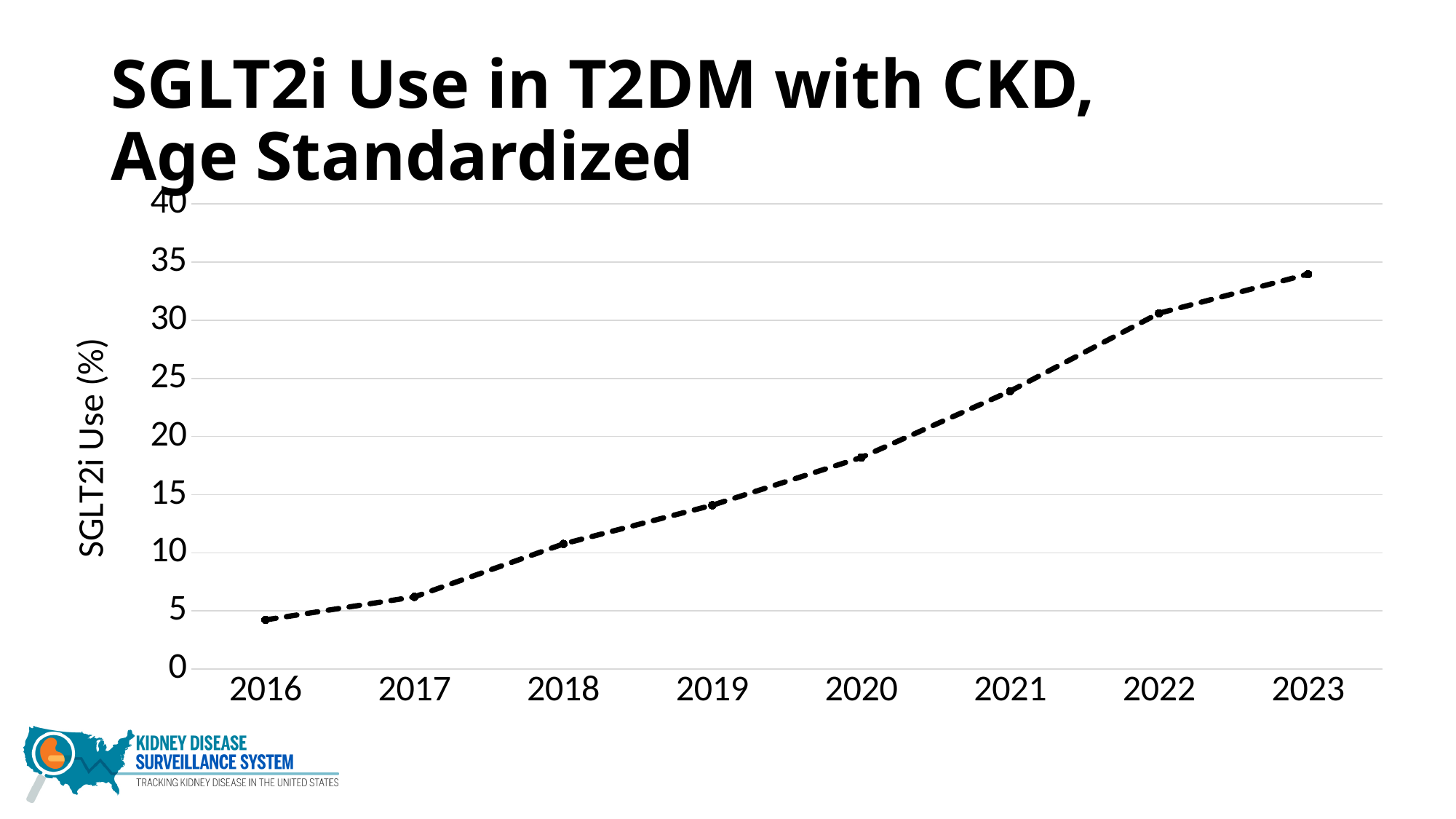
Which year has the lowest SGLT2i use? 2016 Is the value for 2016 greater or less than 5? less Is the value for 2020 greater or less than 15? greater What is the title of the chart? SGLT2i Use in T2DM with CKD, Age Standardized What is the label of the y axis? SGLT2i Use (%) How many years are plotted on the x axis? 8 Does SGLT2i use rise or fall from 2016 to 2023? rise Which year has a larger value, 2019 or 2021? 2021 What kind of chart is shown on the slide? line chart Which year has the highest SGLT2i use? 2023 Is the value for 2018 greater or less than 15? less